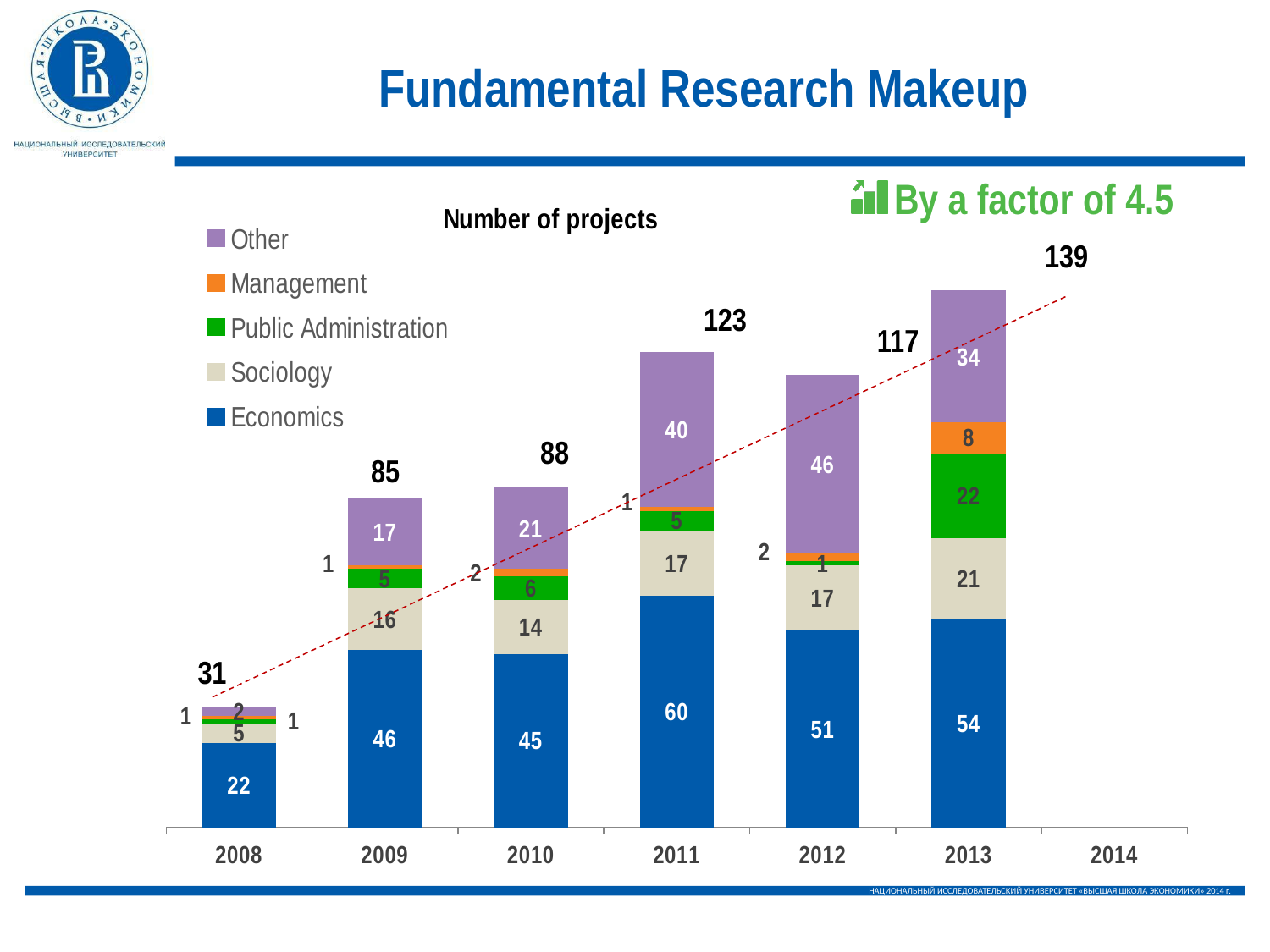
Which year has the highest total number of projects? 2013 How many years have a bar plotted in the chart? 6 Which year has the lowest total number of projects? 2008 How many series does the legend list? 5 What is the Economics value for 2011? 60 What is the Public Administration value for 2013? 22 What is the Other value for 2013? 34 What is the difference between the Economics values for 2011 and 2012? 9 What is the total number of projects shown above the 2012 bar? 117 What is the title of the chart? Number of projects What kind of chart is shown on the slide? Stacked bar chart Which is larger, the Sociology value for 2013 or for 2010? 2013